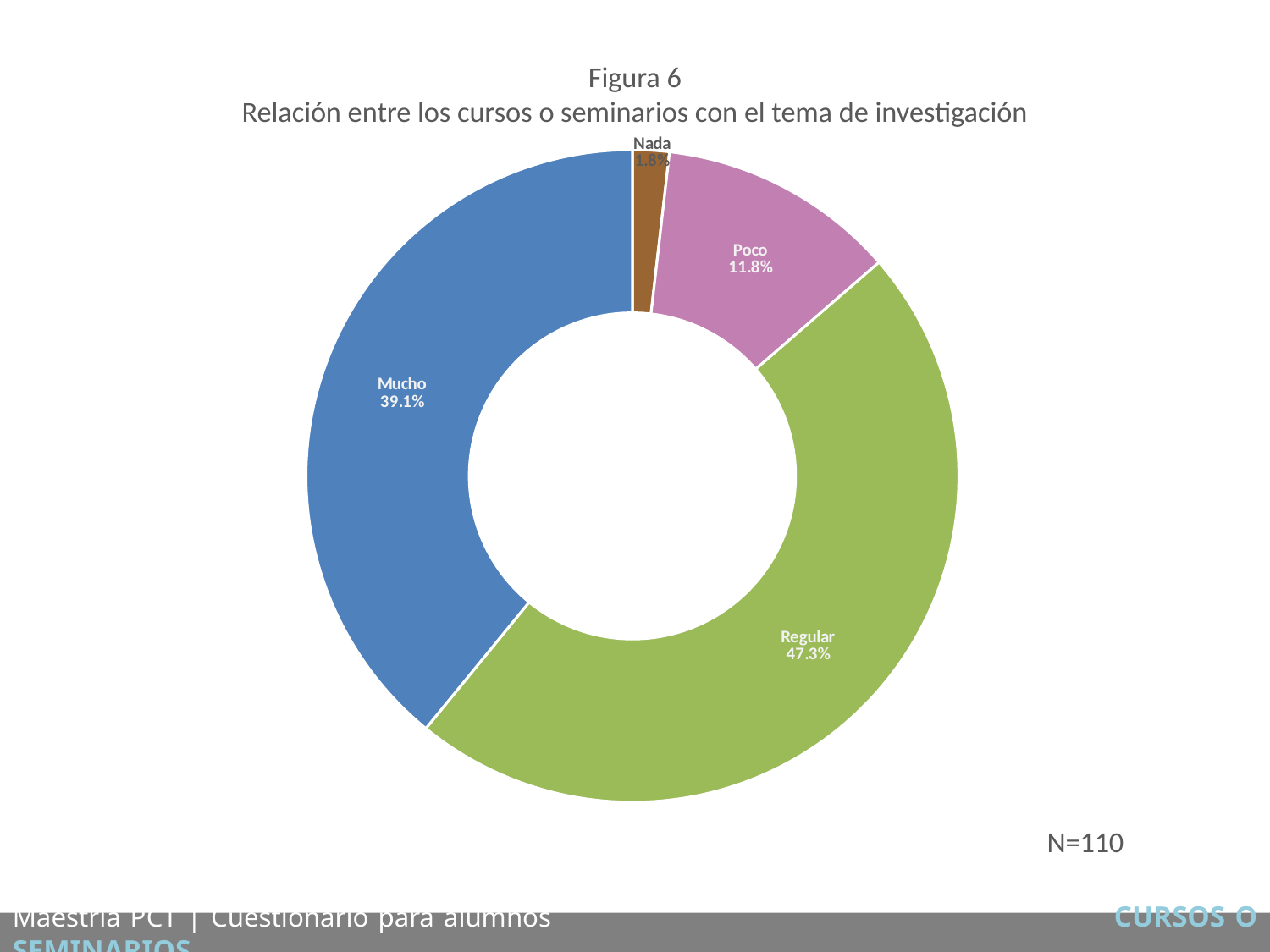
Which slice is larger, Poco or Mucho? Mucho What kind of chart is shown on the slide? Pie chart (doughnut) What is the title of the chart? Figura 6 Relación entre los cursos o seminarios con el tema de investigación What percentage of the chart is the Poco slice? 11.8% What percentage of the chart is the Regular slice? 47.3% Which category has the smallest share of the chart? Nada Which category has the largest share of the chart? Regular What percentage of the chart is the Nada slice? 1.8% What sample size (N) is shown on the slide? N=110 What is the difference in percentage points between the Regular and Mucho slices? 8.2 What percentage of the chart is the Mucho slice? 39.1% How many categories are shown in the chart? 4